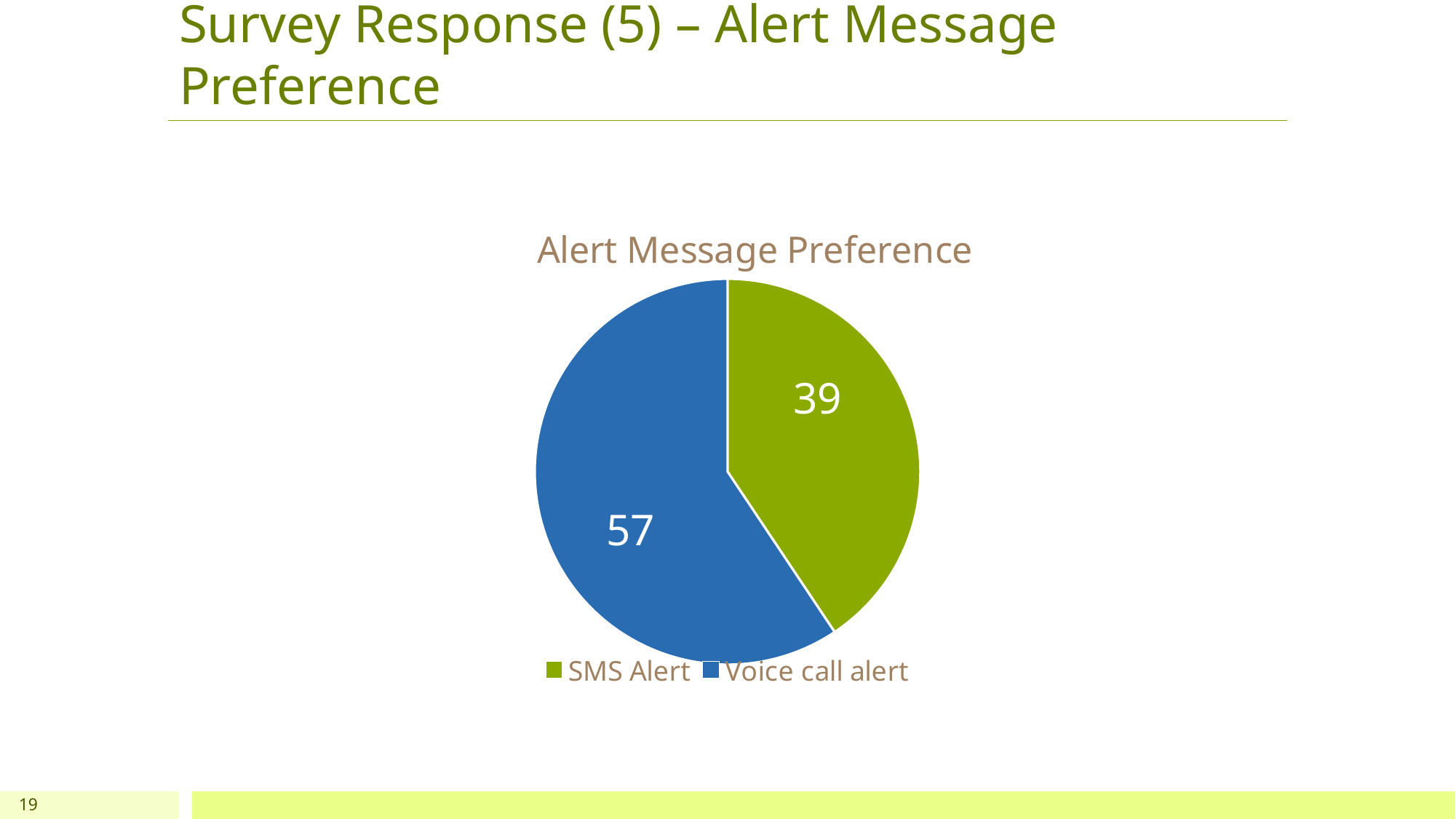
What is the title of the chart? Alert Message Preference What is the value for Voice call alert? 57 Which category has the smallest slice of the pie? SMS Alert Which category has the largest slice of the pie? Voice call alert What kind of chart is shown on the slide? Pie chart Which is larger, SMS Alert or Voice call alert? Voice call alert How many categories does the pie chart show? 2 What is the total of the two slices in the pie chart? 96 What is the difference between the Voice call alert value and the SMS Alert value? 18 What is the value for SMS Alert? 39 What colour is the SMS Alert slice? Green